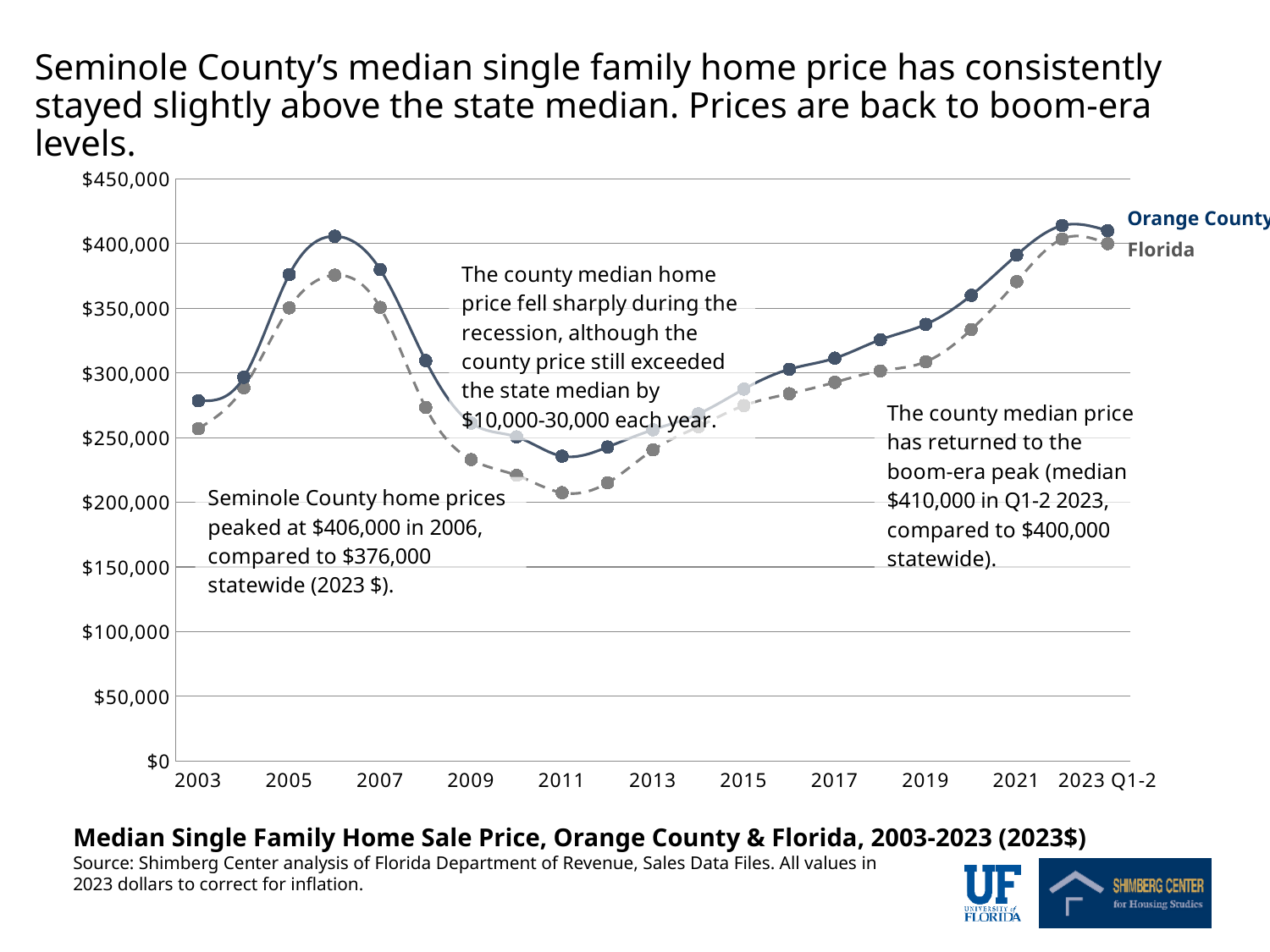
How many series does the chart show? 2 Is the Orange County value for 2011 greater or less than $250,000? less What kind of chart is shown on the slide? Line chart In which year does the Orange County series reach its lowest value? 2011 In 2006, which series has the higher value, Orange County or Florida? Orange County Do the Orange County values rise or fall between 2006 and 2011? fall In which year does the Florida series reach its lowest value? 2011 What are the two series plotted on the chart? Orange County and Florida Is the Florida value for 2017 greater or less than $300,000? less Is the Orange County value for 2003 greater or less than $250,000? greater What is the title of the chart? Median Single Family Home Sale Price, Orange County & Florida, 2003-2023 (2023$)